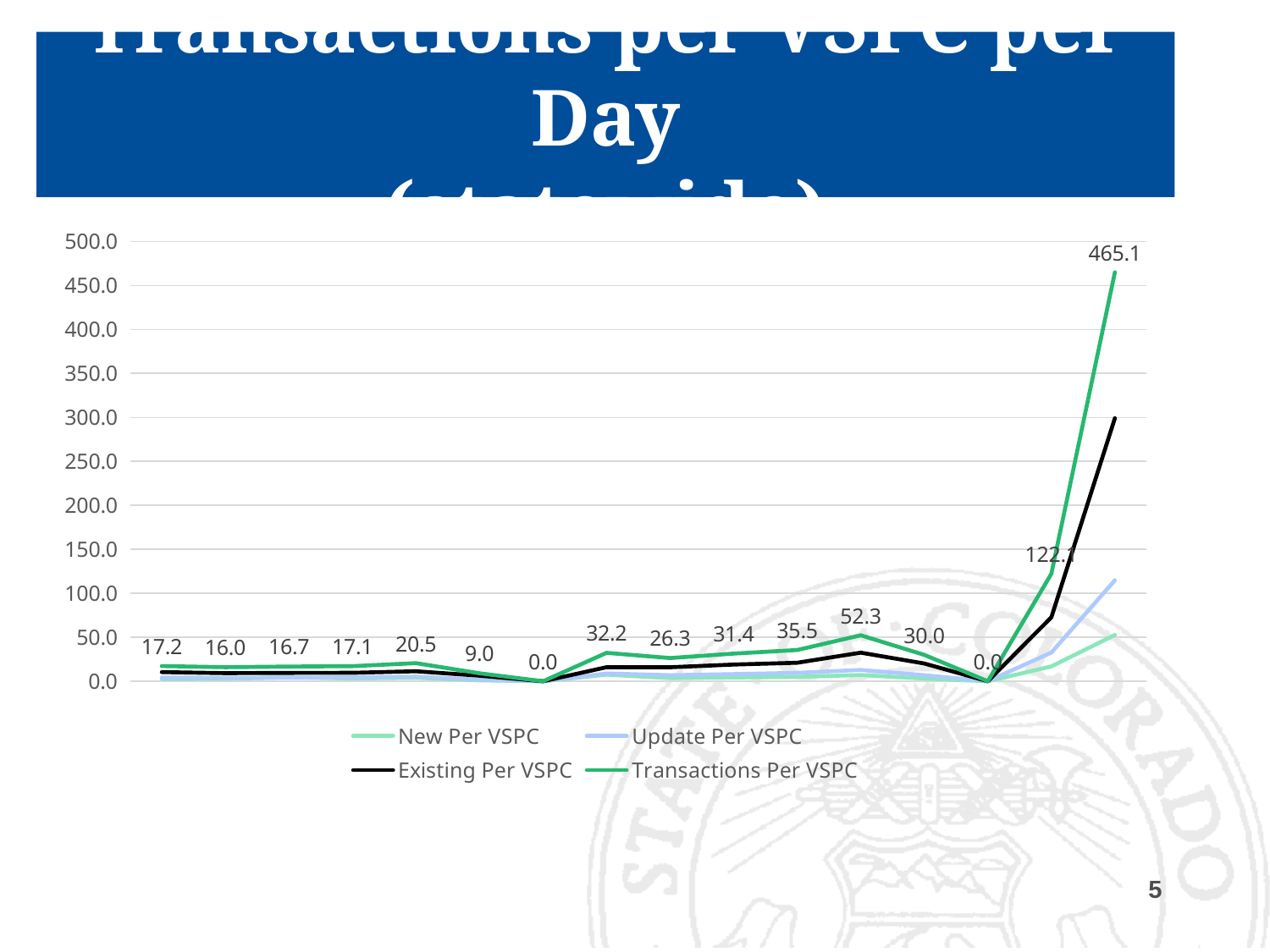
How many data points are labeled on the Transactions Per VSPC line? 16 What is the lowest labeled value on the Transactions Per VSPC line? 0.0 What is the difference between the two highest labeled values on the Transactions Per VSPC line, 465.1 and 122.1? 343.0 What kind of chart is shown on the slide? line chart How many series does the legend list? 4 Is the final value of the Update Per VSPC line greater or less than 150.0? less What colour is the Existing Per VSPC line in the legend? black By how much does the Transactions Per VSPC line drop from the 52.3 point to the next labeled point, 30.0? 22.3 At the final point on the x axis, which is larger: Transactions Per VSPC or Existing Per VSPC? Transactions Per VSPC Does the Transactions Per VSPC line rise or fall between its last two labeled points (122.1 and 465.1)? rise Is the final value of the Existing Per VSPC line greater or less than 250.0? greater What is the highest labeled value on the Transactions Per VSPC line? 465.1